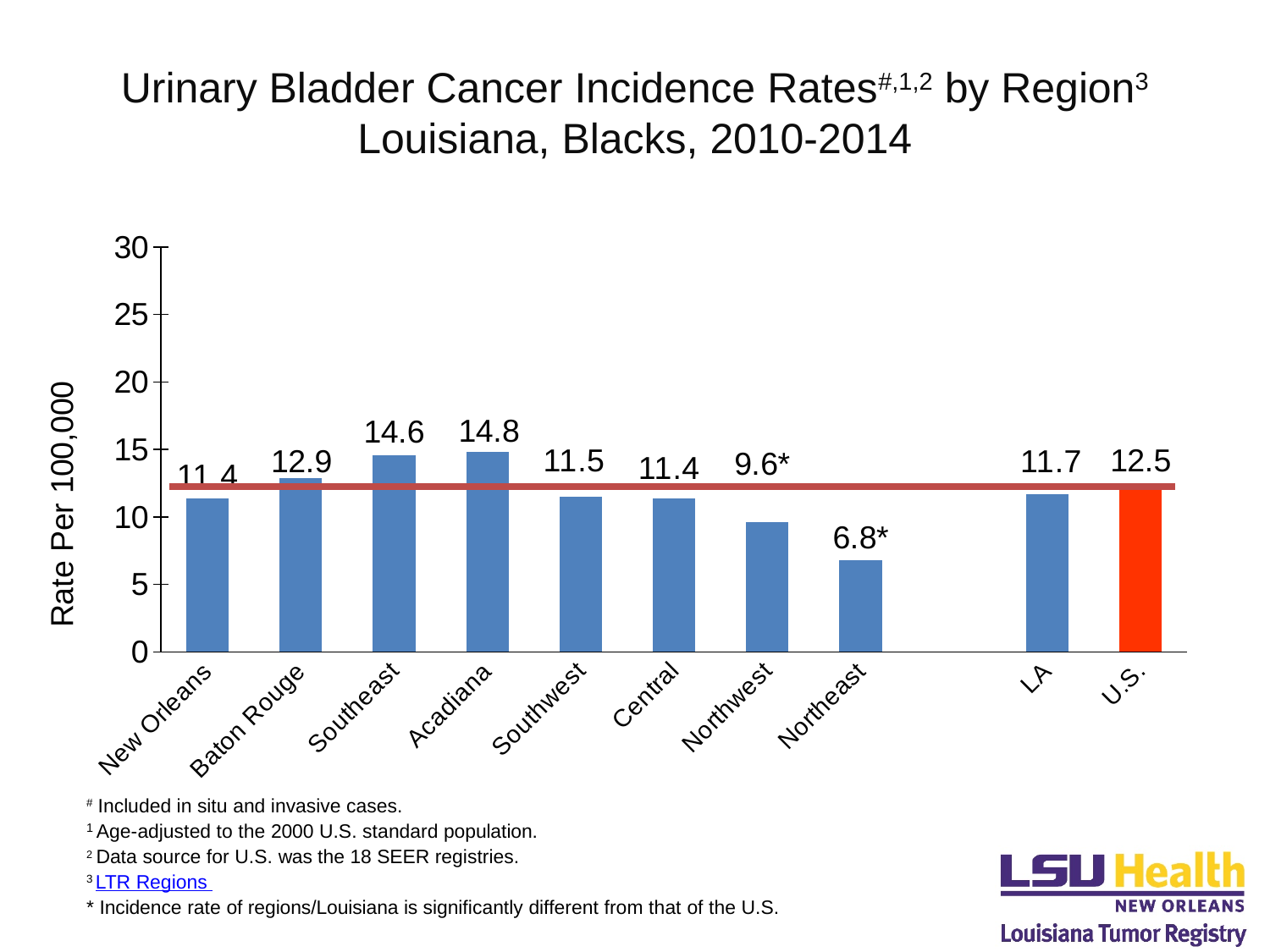
What is the incidence rate shown for the Northeast region? 6.8* What is the difference between the incidence rates for Southeast and Baton Rouge? 1.7 Which has a higher incidence rate, Baton Rouge or Southwest? Baton Rouge What is the difference between the U.S. rate and the LA rate? 0.8 How many bars are plotted on the chart? 10 Which region has the lowest incidence rate on the chart? Northeast What is the urinary bladder cancer incidence rate for Acadiana? 14.8 Which region has the highest incidence rate on the chart? Acadiana What is the incidence rate for the U.S. bar? 12.5 Is the value for Northwest greater or less than 10? less What is the label of the vertical axis? Rate Per 100,000 What kind of chart is shown on the slide? Bar chart